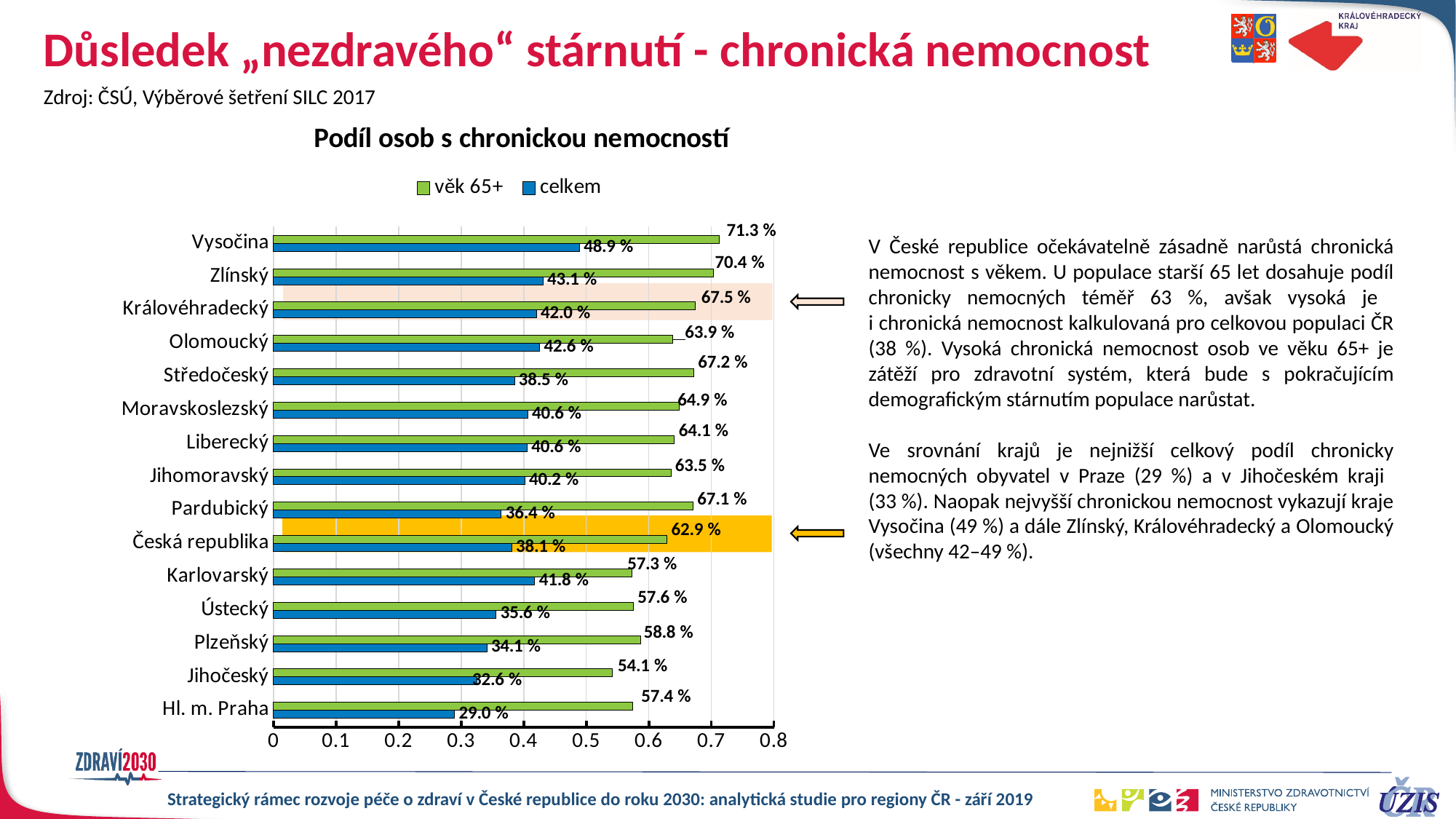
Which category has the lowest value for 'celkem'? Hl. m. Praha What is the difference between the 'věk 65+' and 'celkem' values for Vysočina? 22.4 percentage points What is the title of the chart? Podíl osob s chronickou nemocností Which category has the lowest value for 'věk 65+'? Jihočeský What type of chart is shown on the slide? Bar chart How many categories (regions, including Česká republika) are shown on the chart? 15 What is the value for 'věk 65+' for Královéhradecký? 67.5 % What is the value for 'věk 65+' for Česká republika? 62.9 % What is the value for 'celkem' for Hl. m. Praha? 29.0 % Which category has the highest value for 'celkem'? Vysočina Which is larger: the 'věk 65+' value for Zlínský or for Olomoucký? Zlínský How many series does the legend of the chart list? 2